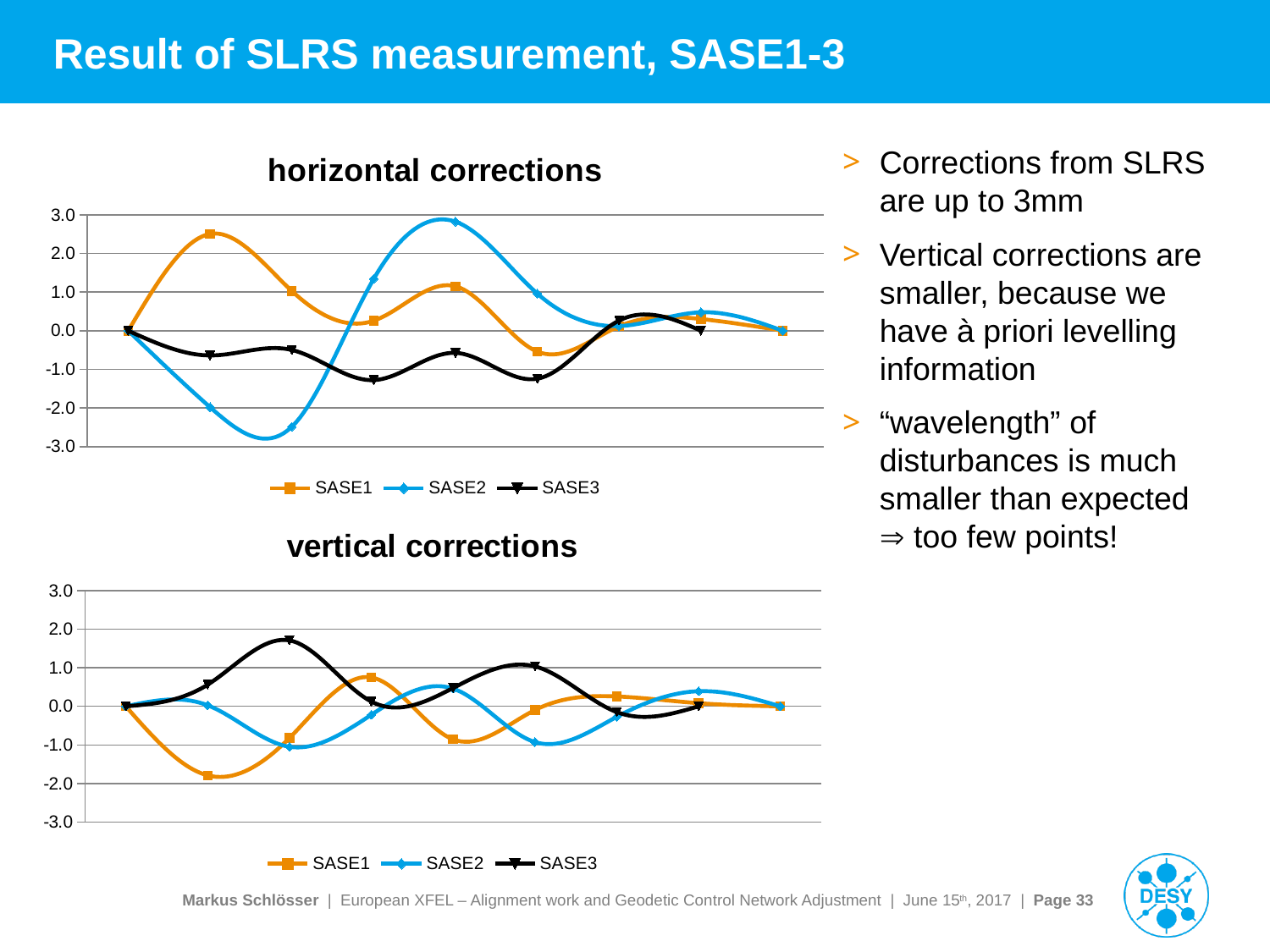
In the "horizontal corrections" chart, is the value of the third point of SASE2 greater or less than -2.0? less In the "horizontal corrections" chart, is the value of the second point of SASE1 greater or less than 2.0? greater How many data points does the SASE1 series have in the "horizontal corrections" chart? 9 In the "horizontal corrections" chart, which series reaches the lowest value? SASE2 In the "vertical corrections" chart, which series reaches the highest value? SASE3 In the "vertical corrections" chart, is the value of the second point of SASE1 greater or less than -1.0? less In the "vertical corrections" chart, which series reaches the lowest value? SASE1 What kind of chart is the "horizontal corrections" chart? line chart Which series are listed in the legend of the "horizontal corrections" chart? SASE1, SASE2, SASE3 How many series does the legend of the "vertical corrections" chart list? 3 What is the highest value shown on the y axis of the "vertical corrections" chart? 3.0